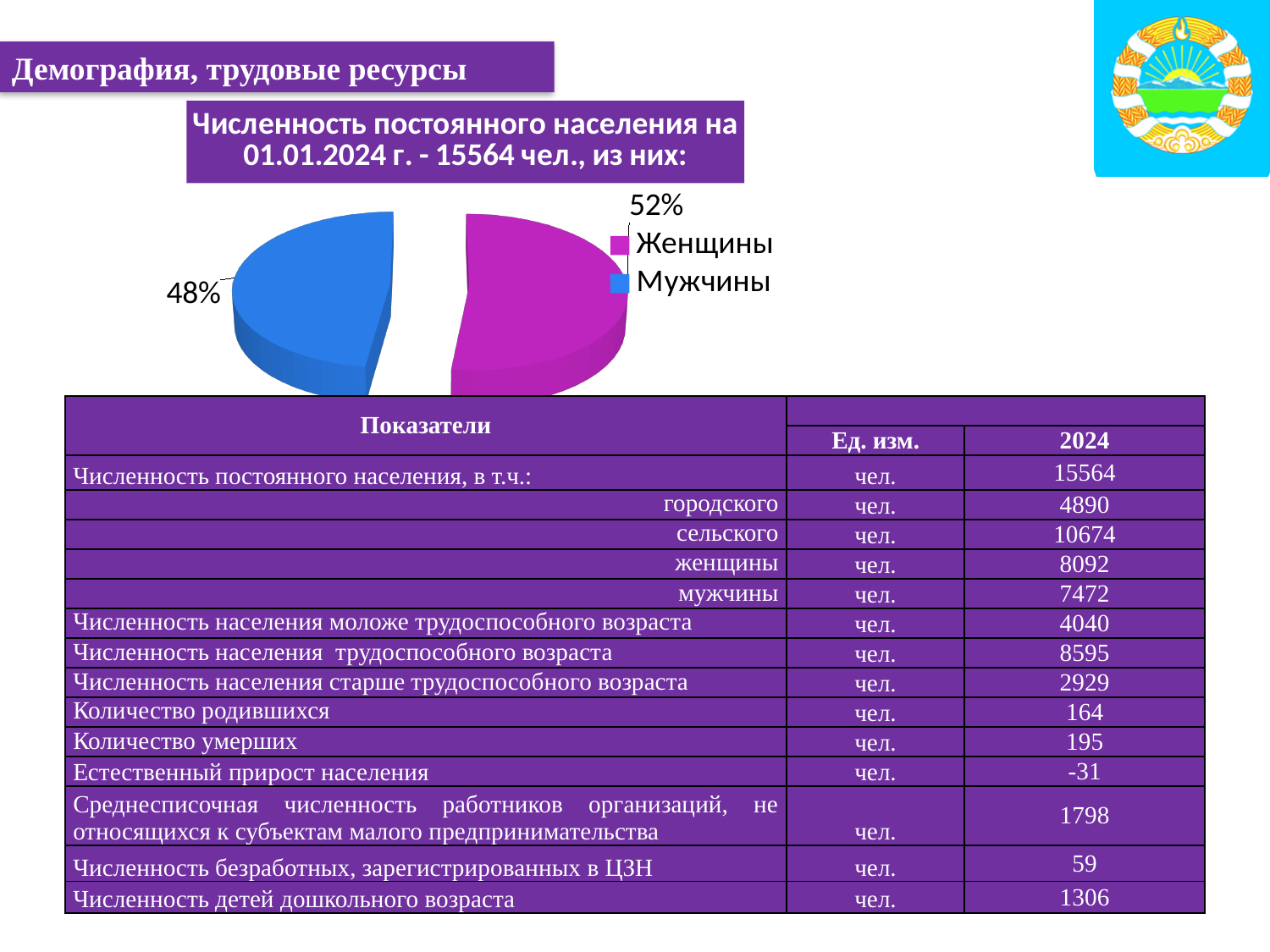
How many entries does the pie chart legend list? 2 Which is larger in the pie chart, Женщины or Мужчины? Женщины Which slice of the pie chart is the largest? Женщины What is the difference in percentage points between the Женщины and Мужчины slices? 4% Is the share of the Мужчины slice greater or less than 50%? less What colour is the Женщины slice in the pie chart? magenta How many slices does the pie chart have? 2 What colour is the Мужчины slice in the pie chart? blue Which slice of the pie chart is the smallest? Мужчины What kind of chart is shown on the slide? pie chart What share of the pie chart does the Женщины slice represent? 52% What share of the pie chart does the Мужчины slice represent? 48%